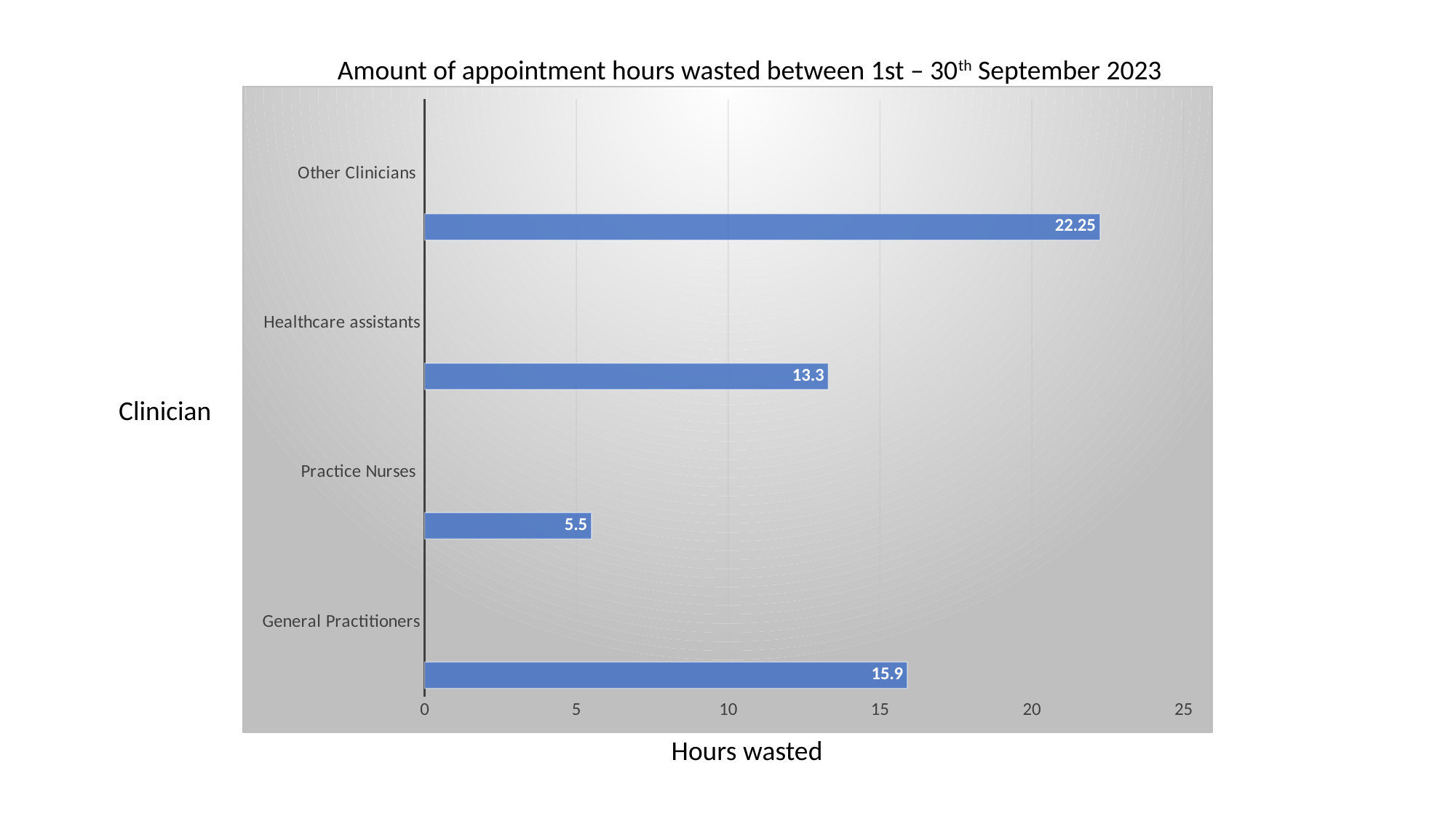
What is the title of the chart? Amount of appointment hours wasted between 1st – 30th September 2023 Which clinician group wasted the fewest appointment hours? Practice Nurses What is the difference in hours wasted between Other Clinicians and General Practitioners? 6.35 How many hours were wasted by Healthcare assistants? 13.3 What is the difference in hours wasted between Healthcare assistants and Practice Nurses? 7.8 How many clinician groups are shown in the chart? 4 How many hours were wasted by Practice Nurses? 5.5 What kind of chart is shown on the slide? bar chart Which wasted more hours, General Practitioners or Healthcare assistants? General Practitioners How many hours were wasted by Other Clinicians? 22.25 Which clinician group wasted the most appointment hours? Other Clinicians How many hours were wasted by General Practitioners? 15.9